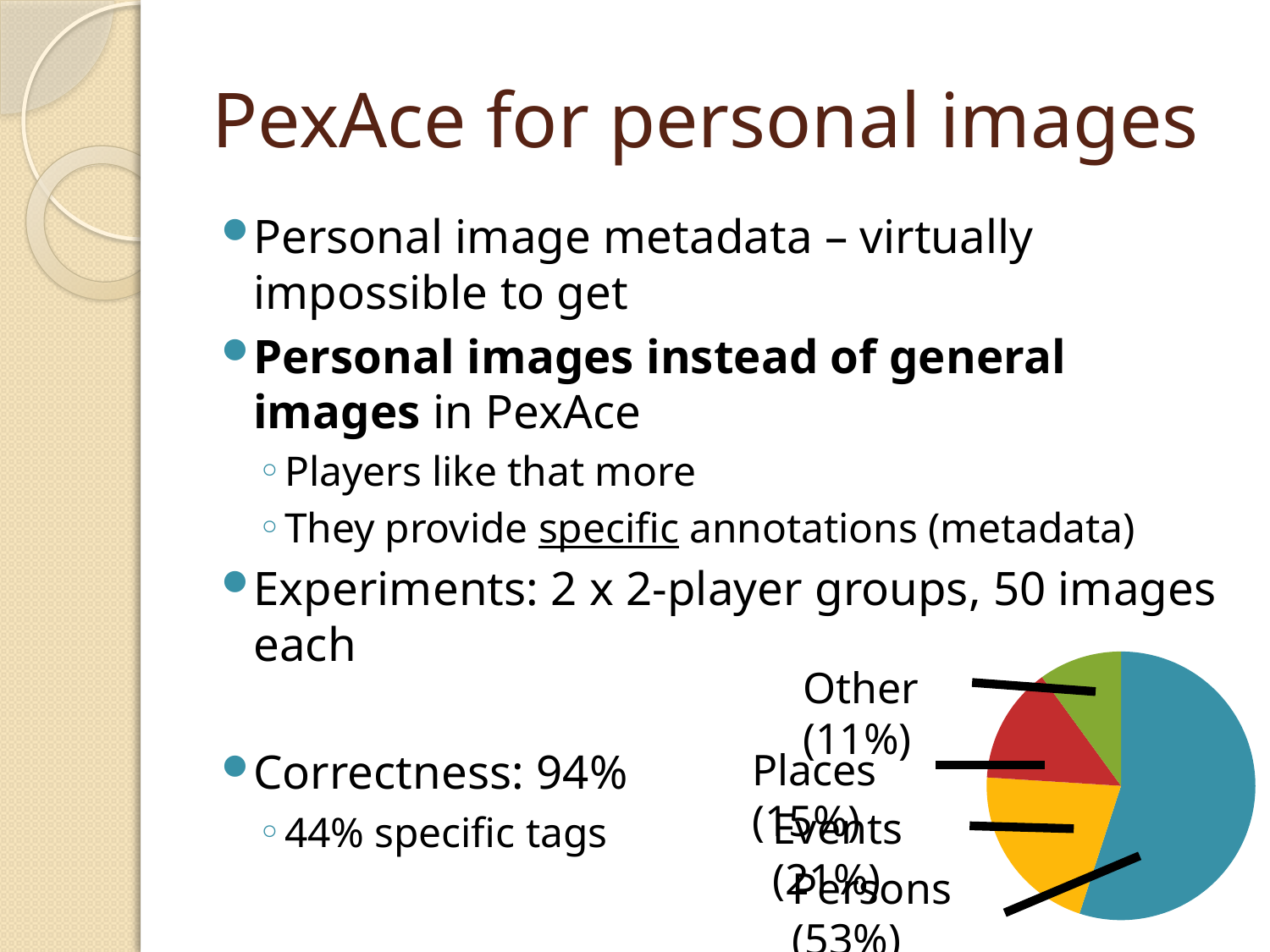
Which is larger in the pie chart, Events or Places? Events How many slices does the pie chart have? 4 What share of the pie chart is Events? 21% What colour is the Persons slice in the pie chart? blue What kind of chart is shown on the slide? pie chart Which category has the largest slice in the pie chart? Persons By how many percentage points does Places exceed Other in the pie chart? 4 What share of the pie chart is Persons? 53% What is the value shown for Other in the pie chart? 11% By how many percentage points does Persons exceed Events in the pie chart? 32 What is the value shown for Places in the pie chart? 15% Which category has the smallest slice in the pie chart? Other